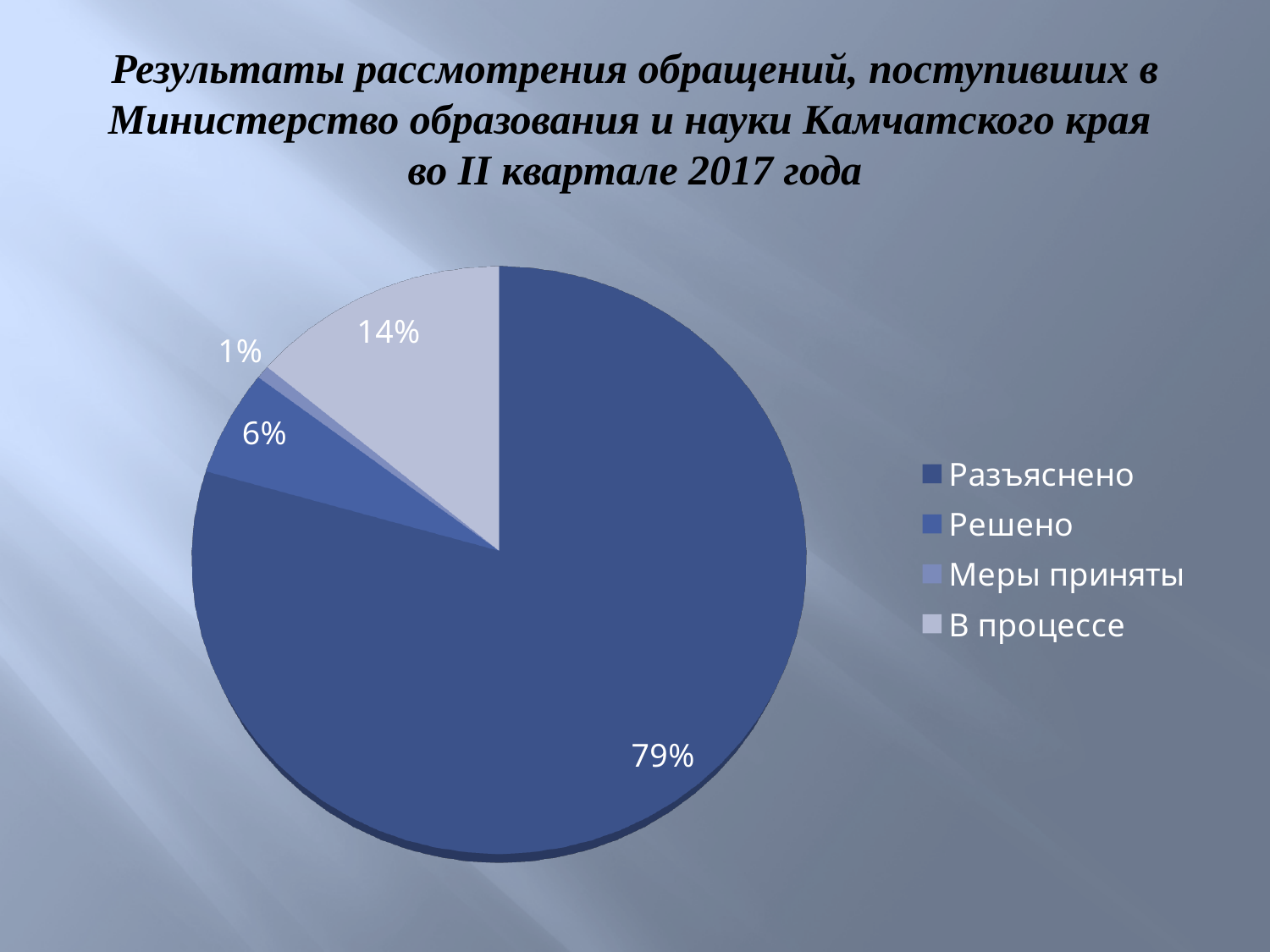
What is the difference in percentage points between "Решено" and "Меры приняты"? 5 What share of the pie does "Разъяснено" take? 79% What share of the pie does "В процессе" take? 14% Which category has the smallest slice of the pie? Меры приняты How many entries does the legend list? 4 Which is larger, the slice for "Решено" or the slice for "В процессе"? В процессе What kind of chart is shown on the slide? pie chart What share of the pie does "Решено" take? 6% What is the difference in percentage points between "Разъяснено" and "В процессе"? 65 How many slices does the pie chart have? 4 Which category has the largest slice of the pie? Разъяснено